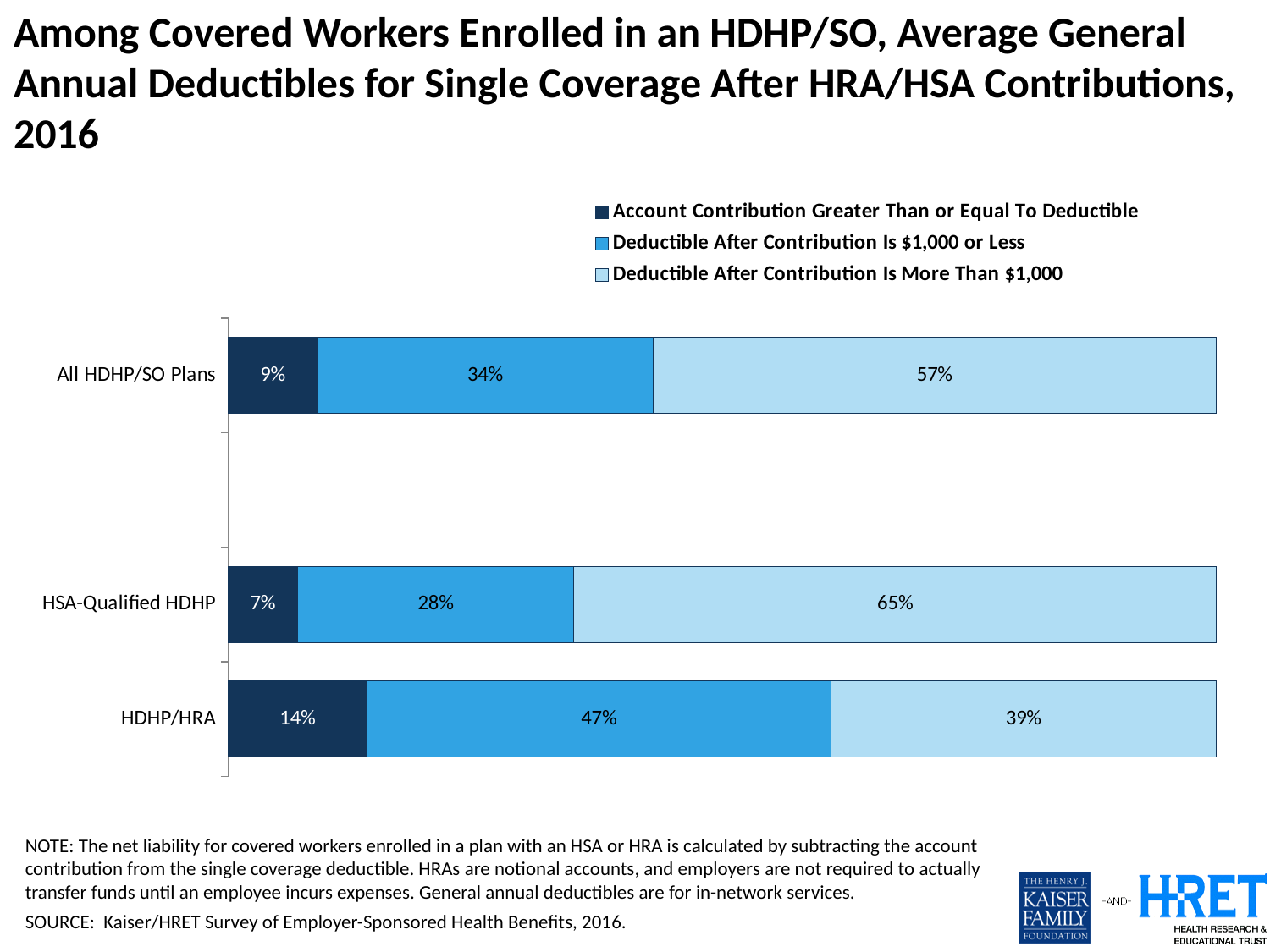
Which plan type has the highest share with a deductible after contribution of more than $1,000? HSA-Qualified HDHP What percentage of HDHP/HRA plans have an account contribution greater than or equal to the deductible? 14% How many series does the legend list? 3 What is the total of the three segments for the HDHP/HRA bar? 100% How many plan categories are shown on the chart? 3 What kind of chart is shown on the slide? Stacked bar chart What percentage of HSA-Qualified HDHP plans have a deductible after contribution of $1,000 or less? 28% Which is larger: the share of HDHP/HRA plans with a deductible after contribution of $1,000 or less, or the share with a deductible after contribution of more than $1,000? Deductible After Contribution Is $1,000 or Less What is the difference between the share of HSA-Qualified HDHP plans and HDHP/HRA plans with a deductible after contribution of more than $1,000? 26 percentage points Which legend entry is shown in the darkest blue? Account Contribution Greater Than or Equal To Deductible Which plan type has the lowest share with an account contribution greater than or equal to the deductible? HSA-Qualified HDHP What percentage of All HDHP/SO Plans have a deductible after contribution of more than $1,000? 57%